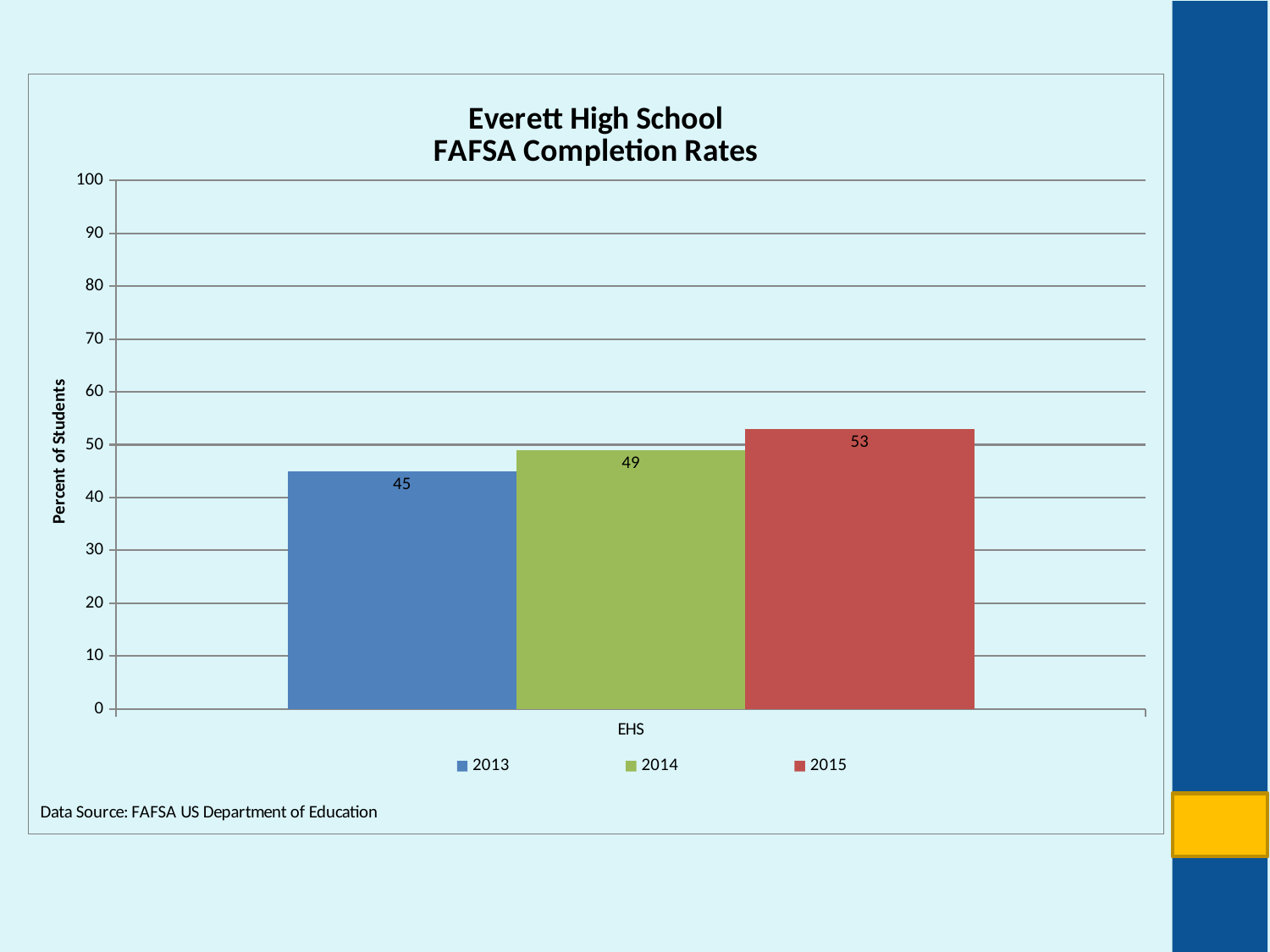
Which year has the highest FAFSA completion rate? 2015 Is the value for 2013 greater or less than 50? less What is the FAFSA completion rate for 2013? 45 Which is larger, the completion rate for 2014 or for 2015? 2015 What is the FAFSA completion rate for 2014? 49 What is the difference between the 2015 and 2013 completion rates? 8 Which year has the lowest FAFSA completion rate? 2013 What is the title of the chart? Everett High School FAFSA Completion Rates What is the FAFSA completion rate for 2015? 53 What kind of chart is shown on the slide? bar chart What is the difference between the 2014 and 2013 completion rates? 4 How many series does the legend list? 3